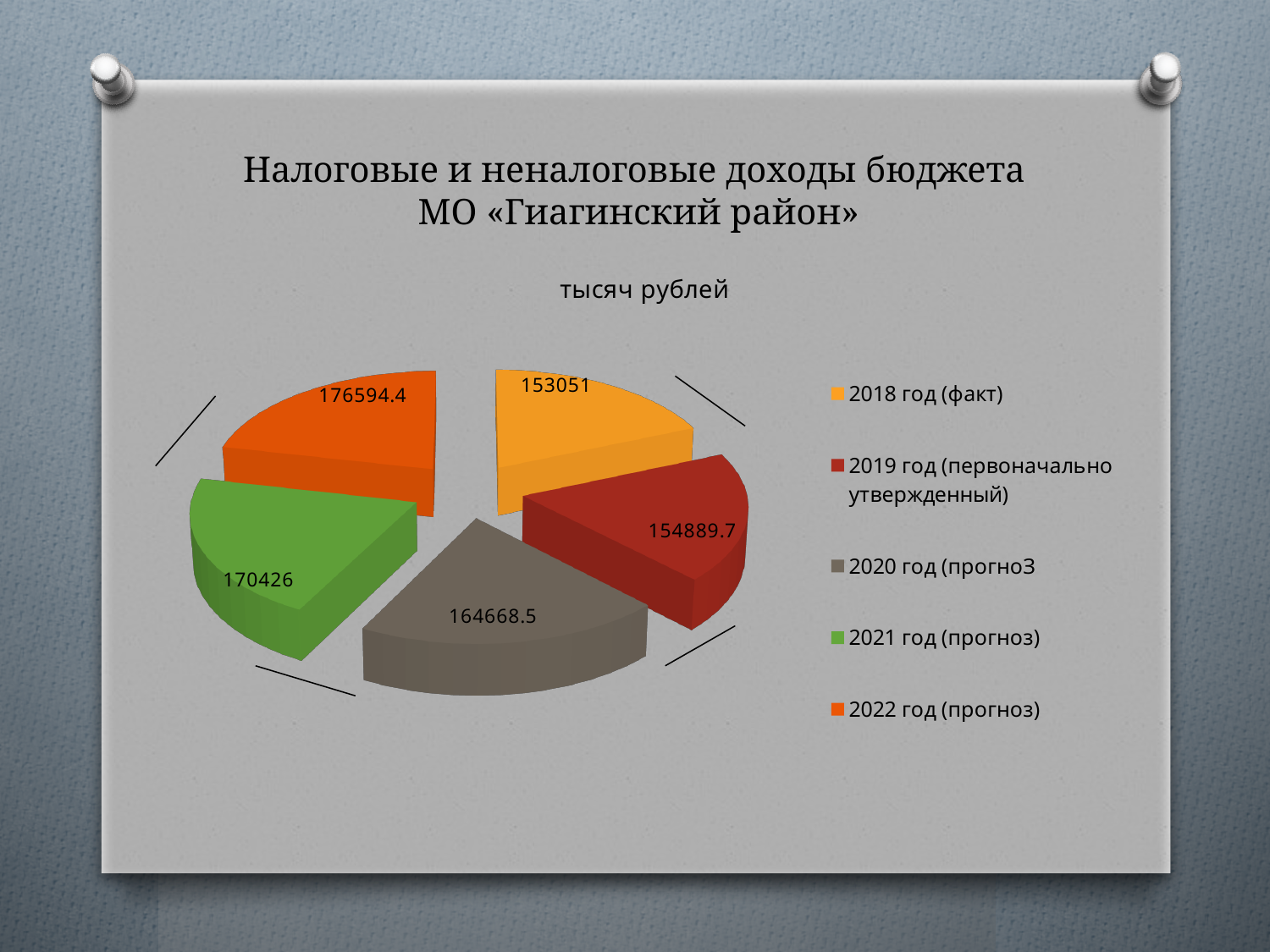
What is the value for 2022 год (прогноз)? 176594.4 Which is larger, the value for 2021 год (прогноз) or 2020 год (прогноз)? 2021 год (прогноз) What is the difference between the values for 2021 год (прогноз) and 2020 год (прогноз)? 5757.5 Which year has the largest slice in the pie chart? 2022 год (прогноз) What is the value for 2018 год (факт)? 153051 Which year has the smallest slice in the pie chart? 2018 год (факт) What is the difference between the values for 2022 год (прогноз) and 2018 год (факт)? 23543.4 What is the value for 2020 год (прогноз)? 164668.5 What is the value for 2019 год (первоначально утвержденный)? 154889.7 What kind of chart is shown on the slide? Pie chart What is the title shown above the pie chart? тысяч рублей How many slices does the pie chart have? 5